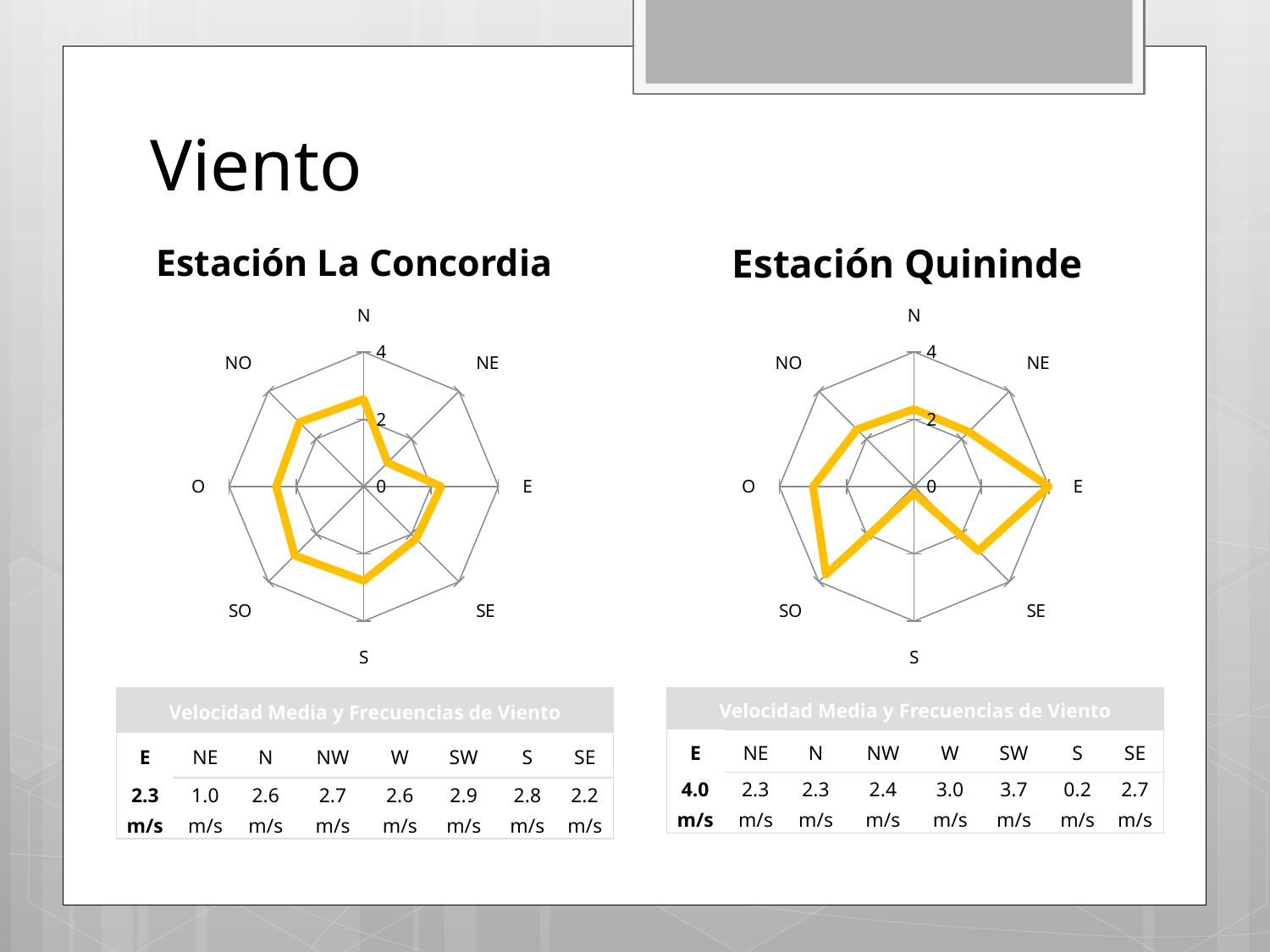
In the Estación Quininde chart, what is the mean wind speed for E? 4.0 m/s In the Estación La Concordia chart, which direction has the highest mean wind speed? SW Which station has the higher mean wind speed for W, Estación La Concordia or Estación Quininde? Estación Quininde In the Estación Quininde chart, what is the difference between the wind speed for E and for S? 3.8 m/s In the Estación Quininde chart, is the value for S greater or less than 2? less What is the maximum value shown on the radial axis of the Estación La Concordia chart? 4 In the Estación La Concordia chart, which direction has the lowest mean wind speed? NE In the Estación La Concordia chart, what is the mean wind speed for SW? 2.9 m/s How many wind directions are plotted on the Estación Quininde chart? 8 What kind of chart is used for Estación La Concordia? Radar chart In the Estación La Concordia chart, what is the difference between the wind speed for NW and for NE? 1.7 m/s In the Estación Quininde chart, which direction has the lowest mean wind speed? S